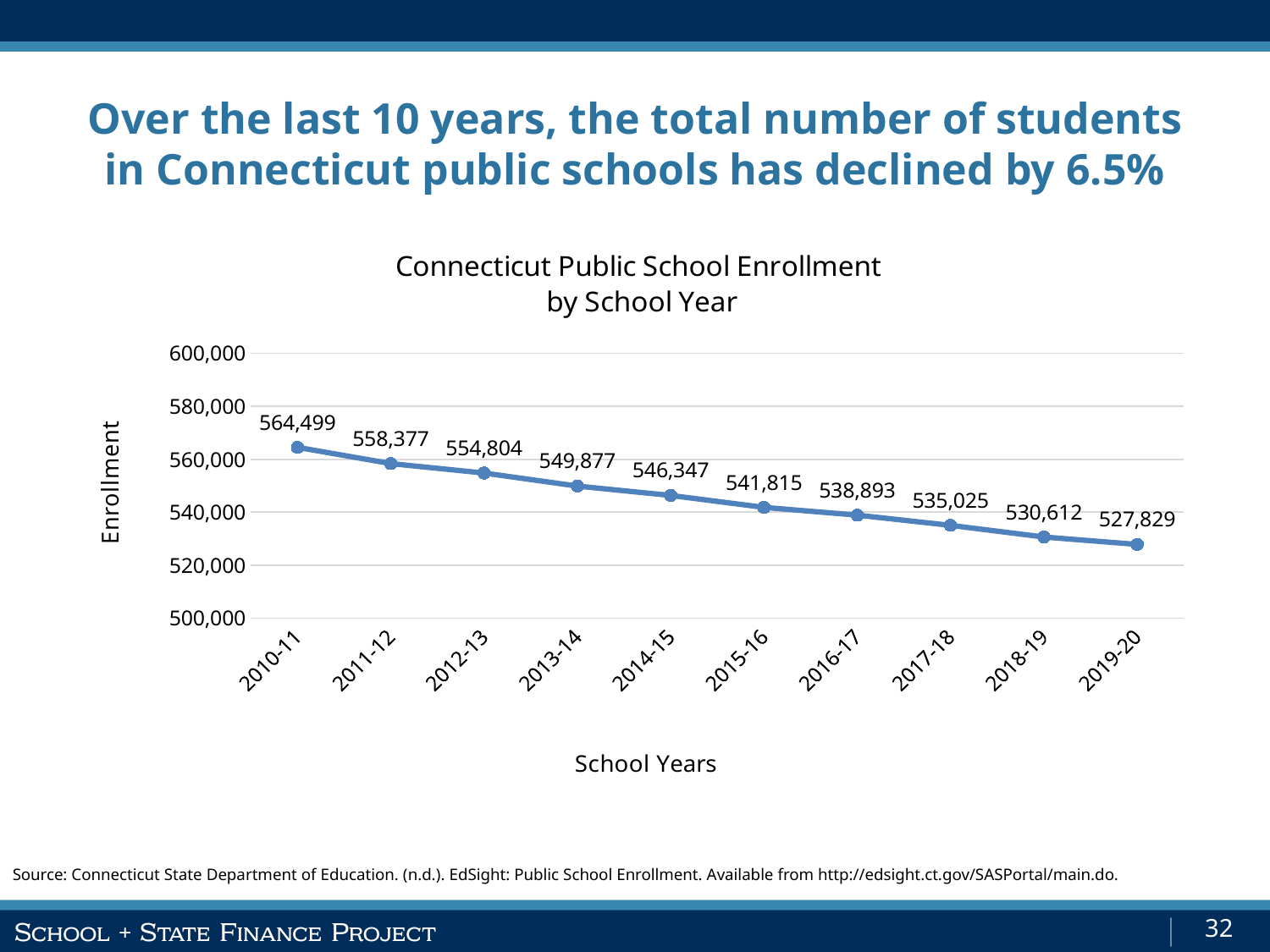
What was the enrollment in the 2015-16 school year? 541,815 What was Connecticut public school enrollment in 2010-11? 564,499 What is the difference in enrollment between 2013-14 and 2014-15? 3,530 Which school year had the highest enrollment? 2010-11 Which school year had the lowest enrollment? 2019-20 Is the enrollment for 2016-17 greater or less than 540,000? less Does enrollment rise or fall across the school years shown? fall What type of chart is used to show enrollment by school year? line chart What was Connecticut public school enrollment in 2019-20? 527,829 How many school years are plotted on the chart? 10 By how much did enrollment fall from 2010-11 to 2019-20? 36,670 Which year had higher enrollment, 2012-13 or 2017-18? 2012-13